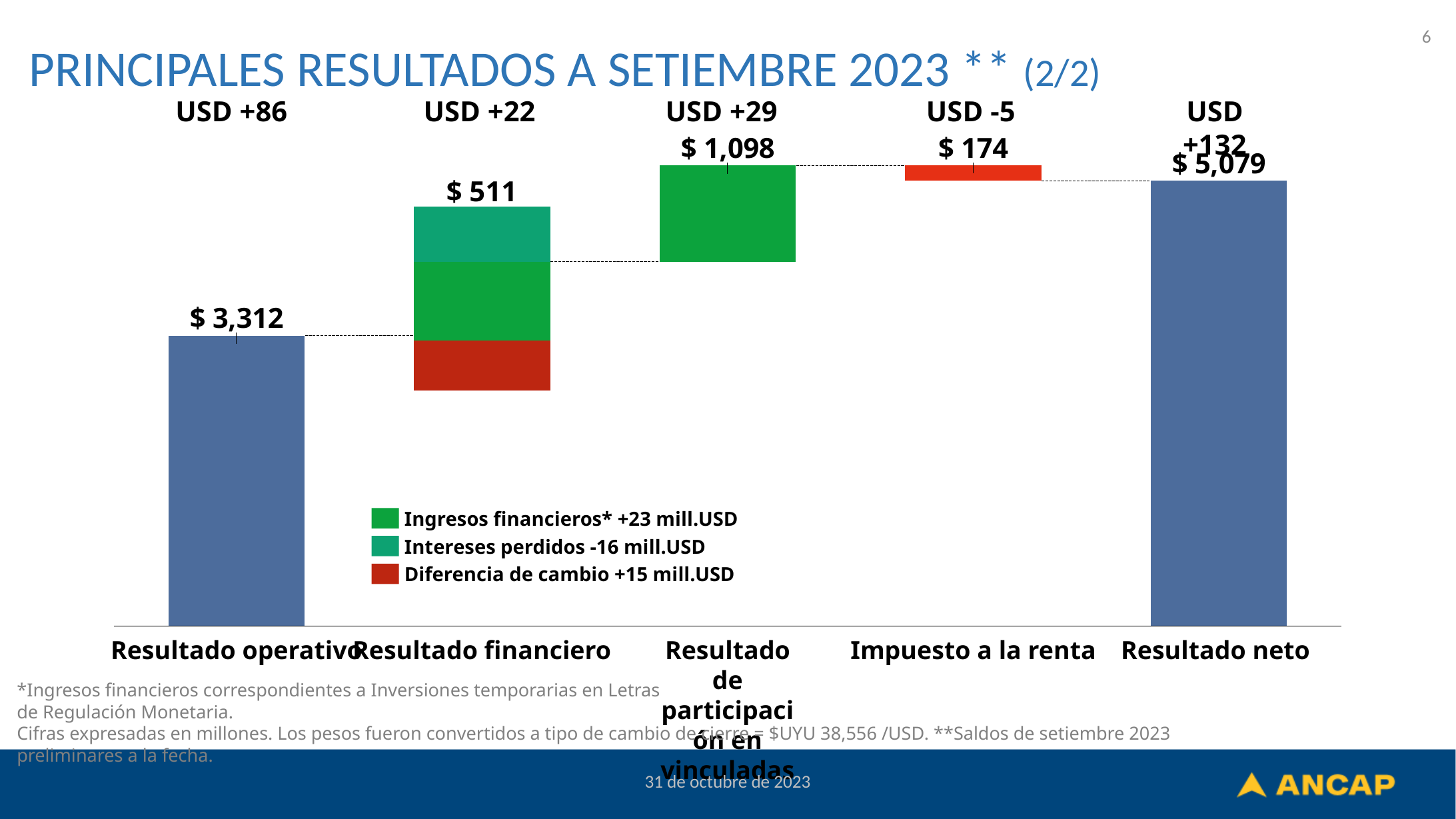
What value is shown for Resultado financiero? $ 511 How many categories are shown along the x axis? 5 What is the difference between Resultado neto and Resultado operativo? $ 1,767 Which is larger, Resultado financiero or Resultado de participación en vinculadas? Resultado de participación en vinculadas What value is shown for Resultado neto? $ 5,079 What value is shown for Resultado operativo? $ 3,312 How many entries does the legend list? 3 Which category has the smallest value shown? Impuesto a la renta Which category has the largest value shown? Resultado neto What USD figure is shown above the Resultado de participación en vinculadas bar? USD +29 What value is shown for Impuesto a la renta? $ 174 What USD figure does the legend give for Intereses perdidos? -16 mill.USD